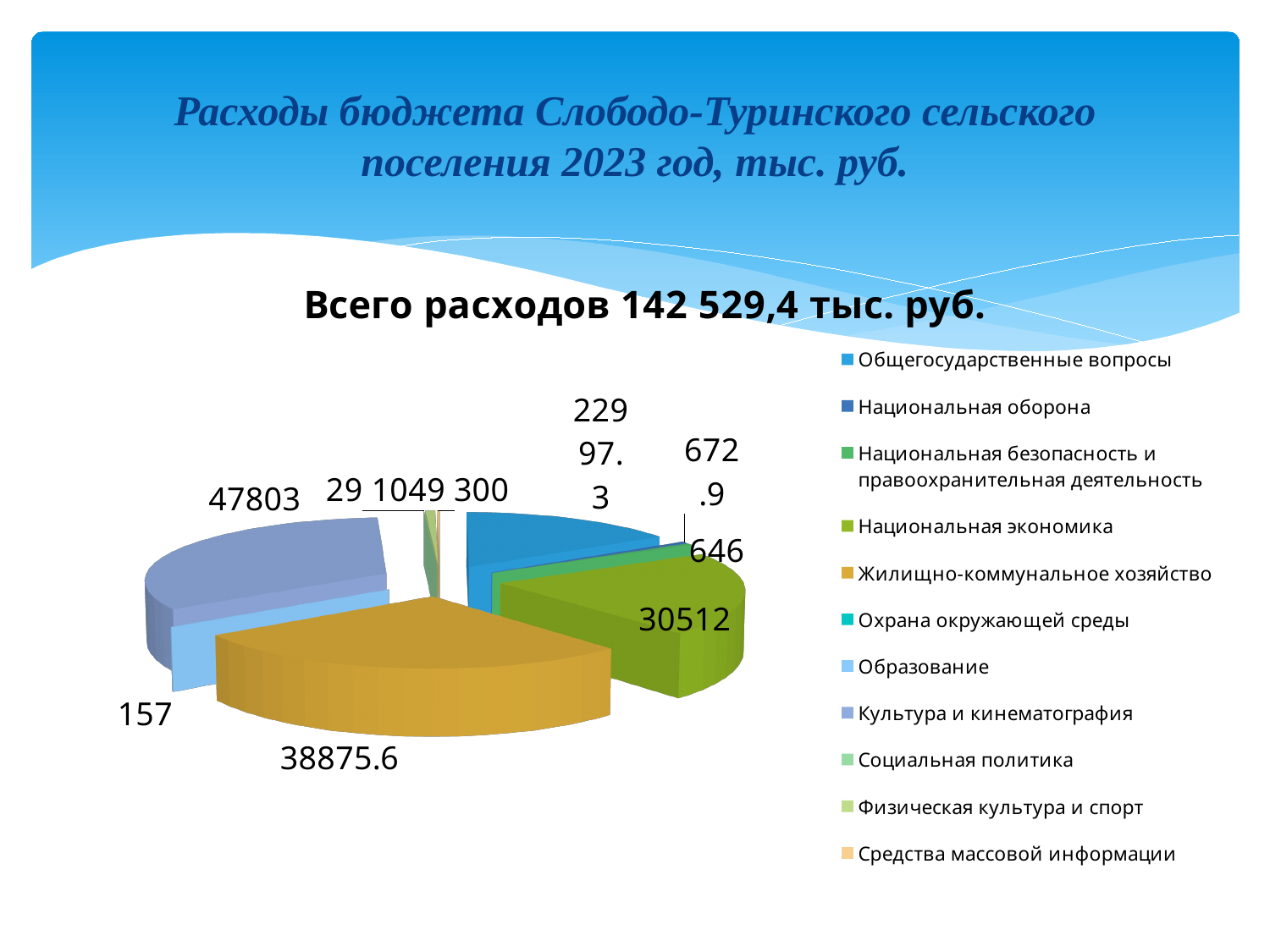
How many categories does the legend of the pie chart list? 11 What is the largest value labelled on the pie chart? 47803 What is the value for Национальная экономика? 30512 What is the difference between Жилищно-коммунальное хозяйство and Национальная экономика? 8363.6 What is the title shown above the pie chart? Всего расходов 142 529,4 тыс. руб. What kind of chart is shown on the slide? pie chart What is the smallest value labelled on the pie chart? 29 What is the value for Жилищно-коммунальное хозяйство? 38875.6 Which is larger, Жилищно-коммунальное хозяйство or Национальная экономика? Жилищно-коммунальное хозяйство What is the value for Общегосударственные вопросы? 22997.3 What is the difference between Национальная экономика and Общегосударственные вопросы? 7514.7 What is the value for Национальная оборона? 672.9